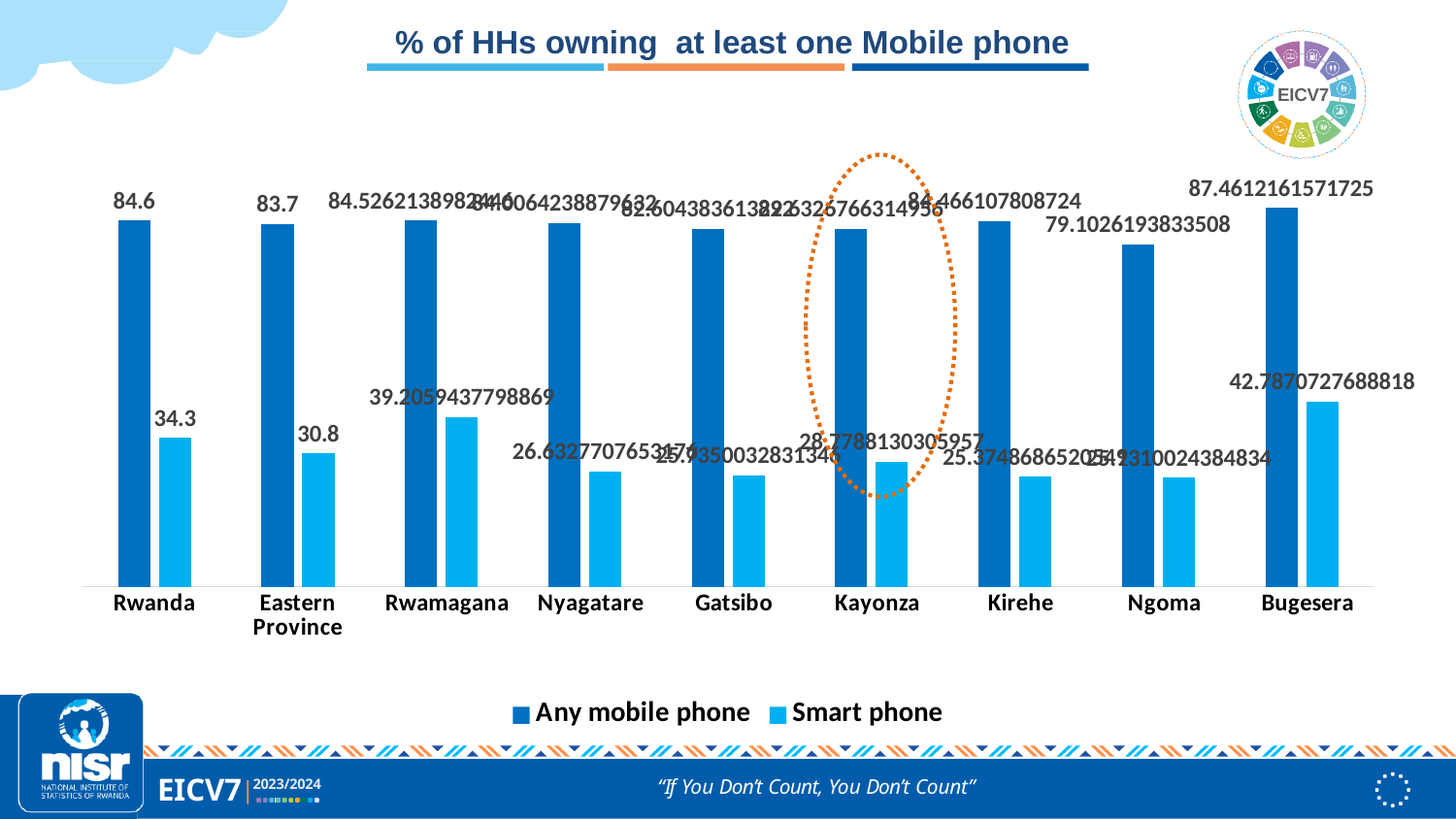
Which category has the lowest value for Any mobile phone? Ngoma Which category is highlighted with a dotted orange circle? Kayonza How many series does the legend list? 2 How many categories are shown on the x axis? 9 What is the value for Any mobile phone in Bugesera? 87.4612161571725 Which category has the highest value for Smart phone? Bugesera Which category has the highest value for Any mobile phone? Bugesera Which is larger, the Smart phone value for Rwanda or for Eastern Province? Rwanda What is the value for Smart phone in Rwamagana? 39.2059437798869 What is the value for Smart phone in Eastern Province? 30.8 What is the value for Any mobile phone in Rwanda? 84.6 What is the difference between Any mobile phone and Smart phone in Rwanda? 50.3